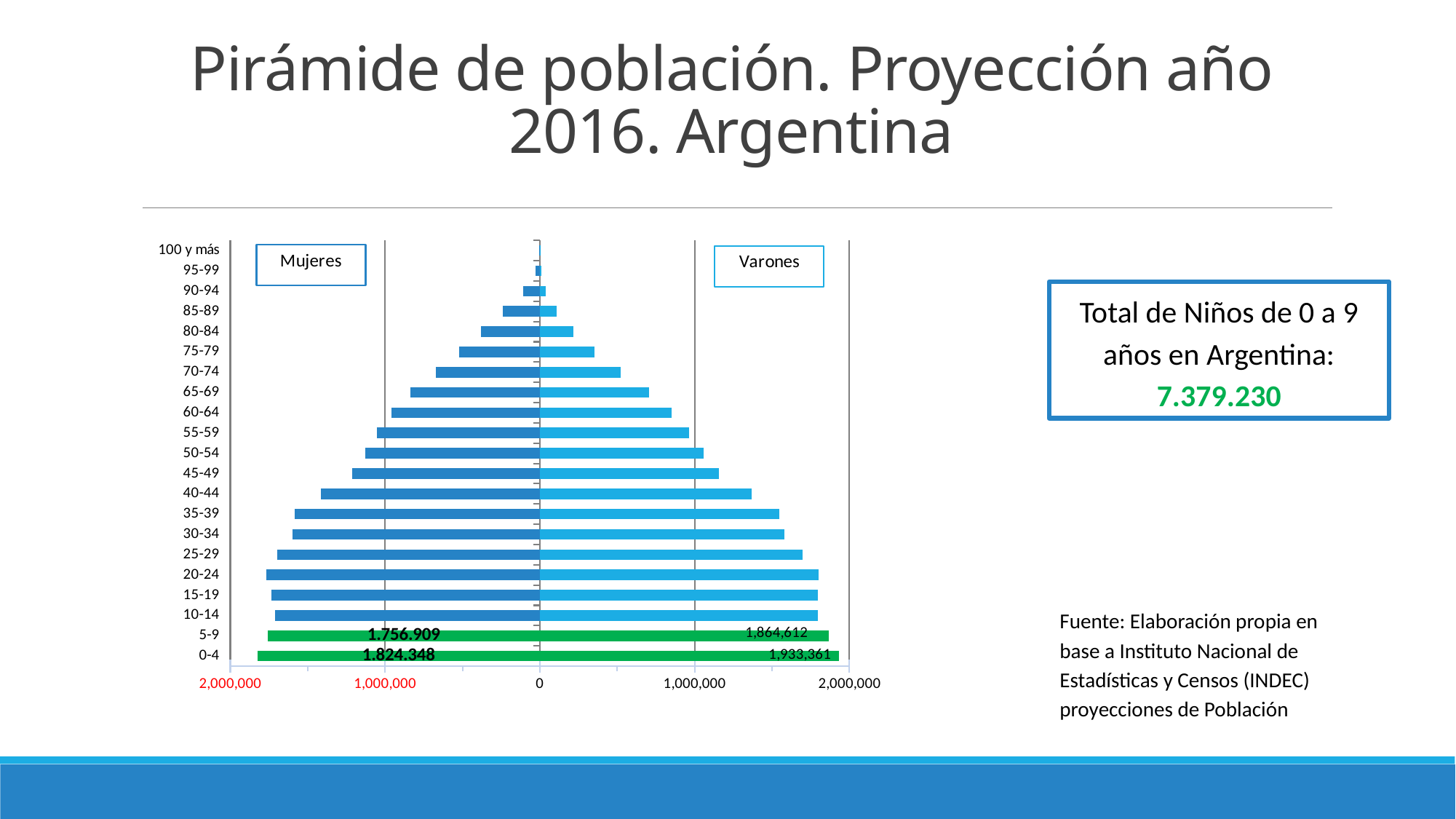
What is the value for Varones in the 5-9 age group? 1,864,612 How many age groups are shown on the chart? 21 What is the value for Varones in the 0-4 age group? 1,933,361 Is the value for Varones in the 70-74 age group greater or less than 1,000,000? less What is the value for Mujeres in the 0-4 age group? 1.824.348 What is the difference between the Varones values for the 0-4 and 5-9 age groups? 68,749 What is the value for Mujeres in the 5-9 age group? 1.756.909 What kind of chart is shown on the slide? Bar chart (population pyramid) Which is larger in the 0-4 age group, Mujeres or Varones? Varones Which age group has the highest value for Varones? 0-4 How many series does the chart show? 2 Is the value for Mujeres in the 20-24 age group greater or less than 1,000,000? greater